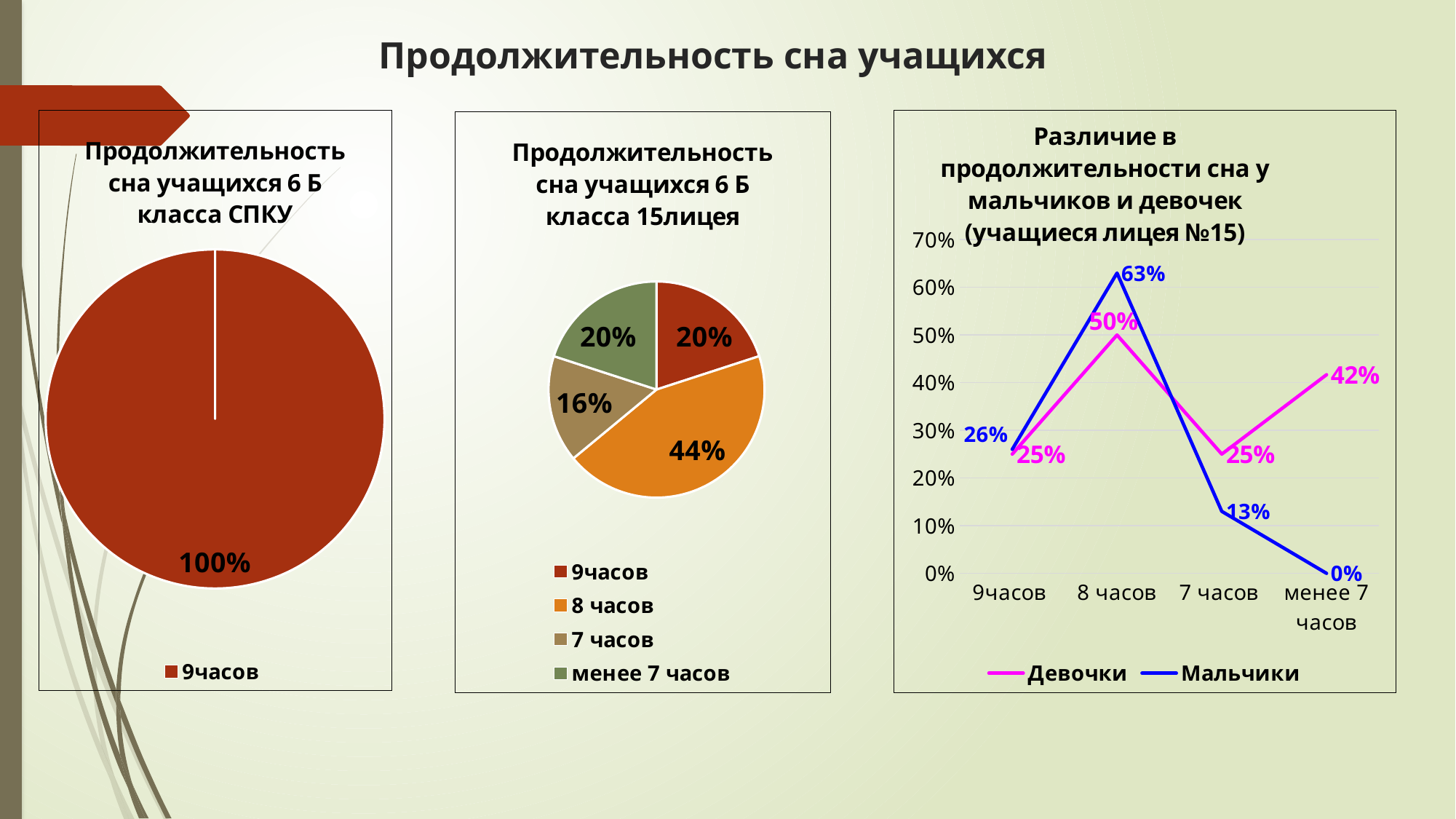
In the left pie chart ('6 Б класса СПКУ'), what share is shown for '9часов'? 100% In the middle pie chart ('6 Б класса 15лицея'), which category has the smallest slice? 7 часов What kind of chart is the right chart, 'Различие в продолжительности сна у мальчиков и девочек'? line chart In the right line chart, what is the value for 'Девочки' at 'менее 7 часов'? 42% What kind of chart is the left chart, 'Продолжительность сна учащихся 6 Б класса СПКУ'? pie chart How many series does the legend of the right line chart list? 2 In the middle pie chart ('6 Б класса 15лицея'), what share is shown for '7 часов'? 16% How many categories does the legend of the middle pie chart ('6 Б класса 15лицея') list? 4 In the middle pie chart ('6 Б класса 15лицея'), which category has the largest slice? 8 часов In the middle pie chart ('6 Б класса 15лицея'), what share is shown for '8 часов'? 44% In the right line chart, what is the value for 'Мальчики' at '8 часов'? 63% In the right line chart, what is the difference between 'Мальчики' and 'Девочки' at '8 часов'? 13%